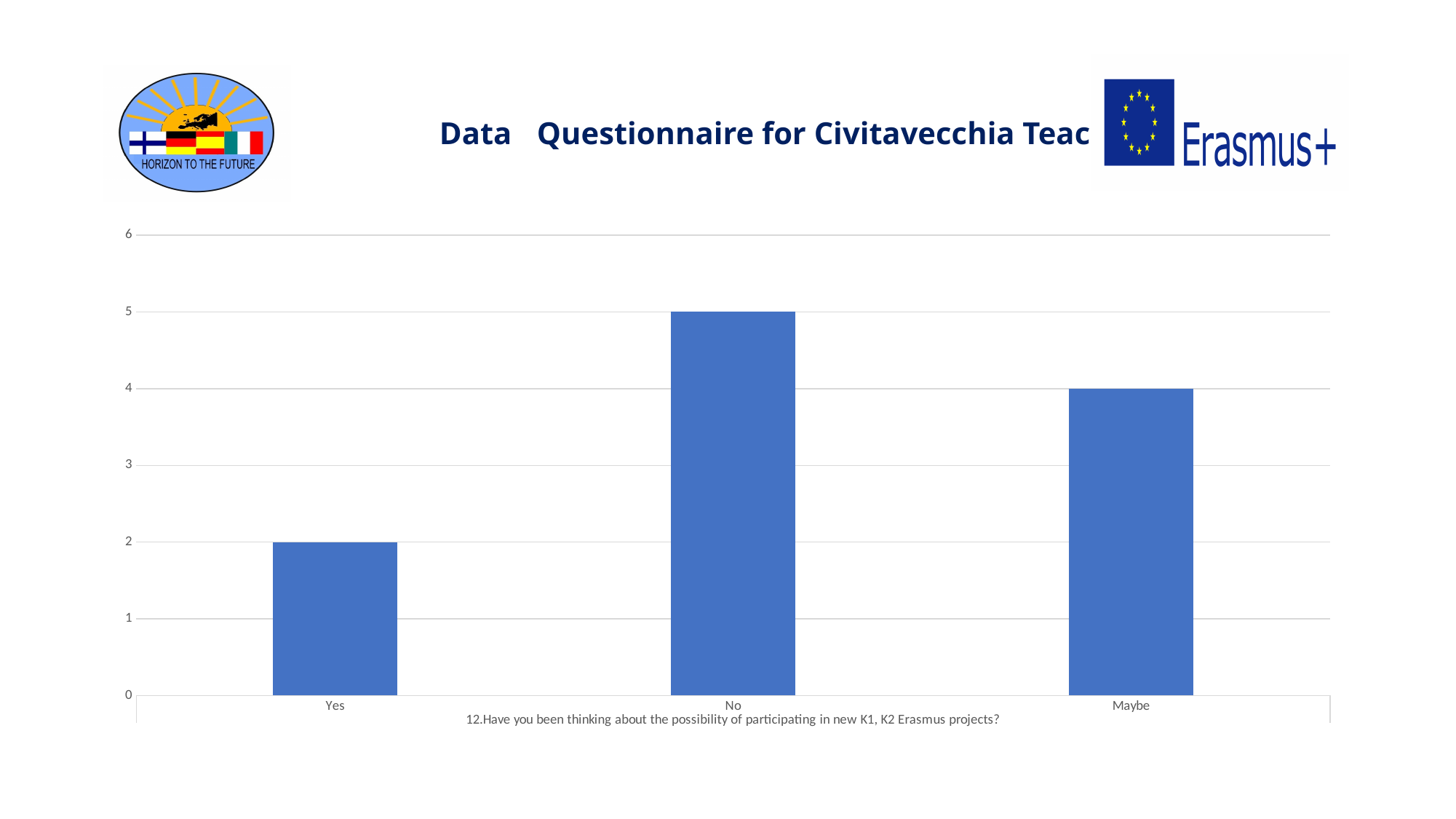
What kind of chart is shown on the slide? bar chart Which category has the highest bar? No Is the value for "No" greater or less than 3? greater How many categories are shown on the x axis of the chart? 3 What is the highest value shown on the vertical axis of the chart? 6 Which category has the lowest bar? Yes What is the value of the bar for "Maybe"? 4 What is the difference between the values for "No" and "Yes"? 3 What is the value of the bar for "Yes"? 2 What is the value of the bar for "No"? 5 Which is larger, the value for "Maybe" or the value for "Yes"? Maybe What is the difference between the values for "Maybe" and "Yes"? 2